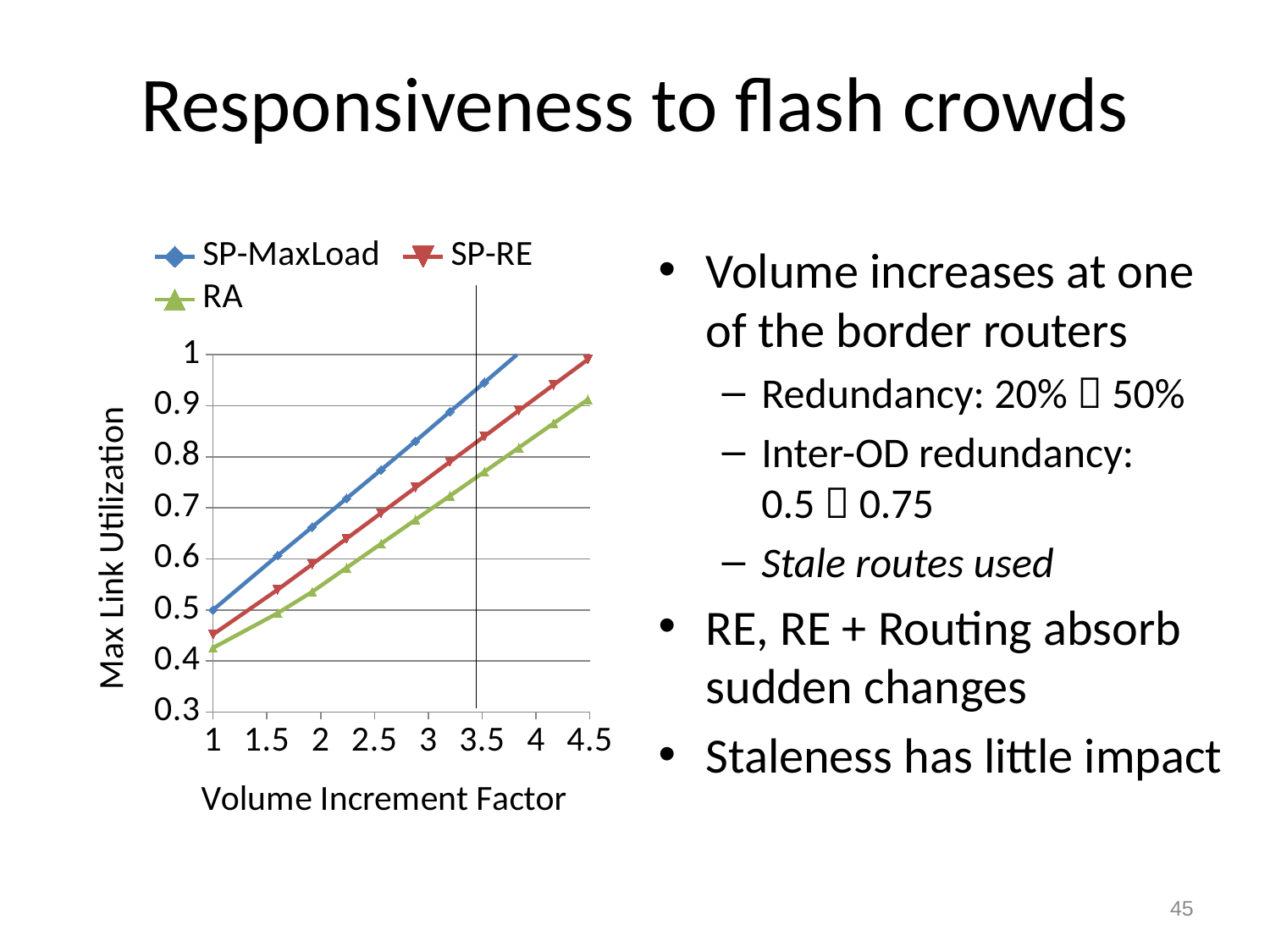
What is the title of the chart's x axis? Volume Increment Factor Is the value for SP-MaxLoad at a Volume Increment Factor of 3 greater or less than 0.8? greater Which series has the lowest Max Link Utilization across the plotted range? RA Is the value for SP-RE at a Volume Increment Factor of 1 greater or less than 0.5? less How many series does the chart legend list? 3 Is the value for RA at a Volume Increment Factor of 4.5 greater or less than 0.8? greater Which series has the highest Max Link Utilization across the plotted range? SP-MaxLoad Does the Max Link Utilization for RA rise or fall as the Volume Increment Factor increases? rise What is the title of the chart's y axis? Max Link Utilization At a Volume Increment Factor of 3, which is larger: the value for SP-MaxLoad or the value for RA? SP-MaxLoad What kind of chart is shown on the slide? line chart Does the Max Link Utilization for SP-MaxLoad rise or fall as the Volume Increment Factor increases? rise